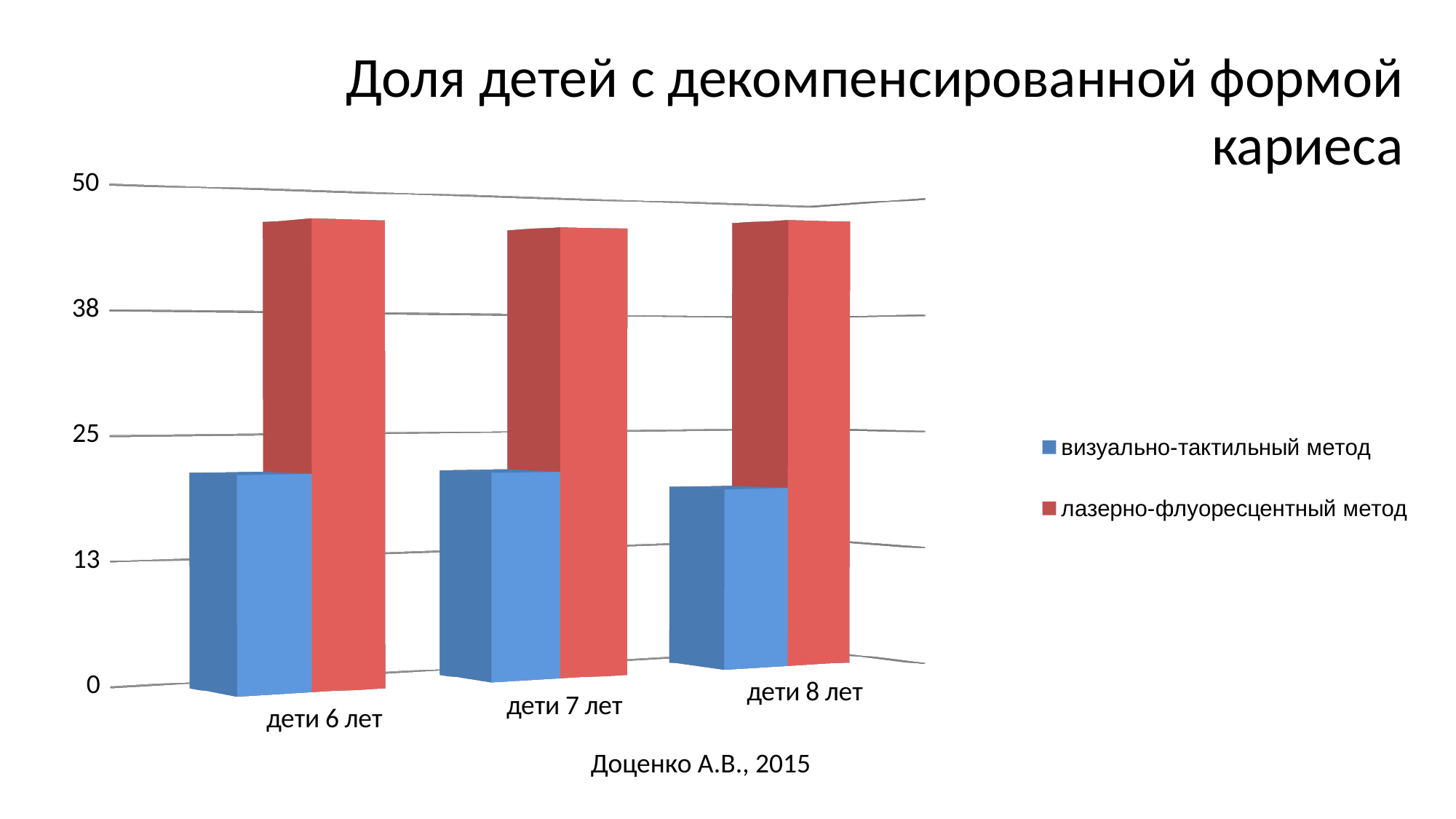
How many series does the legend list? 2 Is the value for визуально-тактильный метод for дети 7 лет greater or less than 13? greater Is the value for лазерно-флуоресцентный метод for дети 7 лет greater or less than 38? greater Is the value for визуально-тактильный метод for дети 6 лет greater or less than 25? less For дети 6 лет, which series has the larger value: визуально-тактильный метод or лазерно-флуоресцентный метод? лазерно-флуоресцентный метод For дети 8 лет, which series has the smaller value: визуально-тактильный метод or лазерно-флуоресцентный метод? визуально-тактильный метод How many categories are shown on the x axis of the chart? 3 What kind of chart is shown on the slide? bar chart What is the title of the chart? Доля детей с декомпенсированной формой кариеса Which series is shown in red in the chart? лазерно-флуоресцентный метод